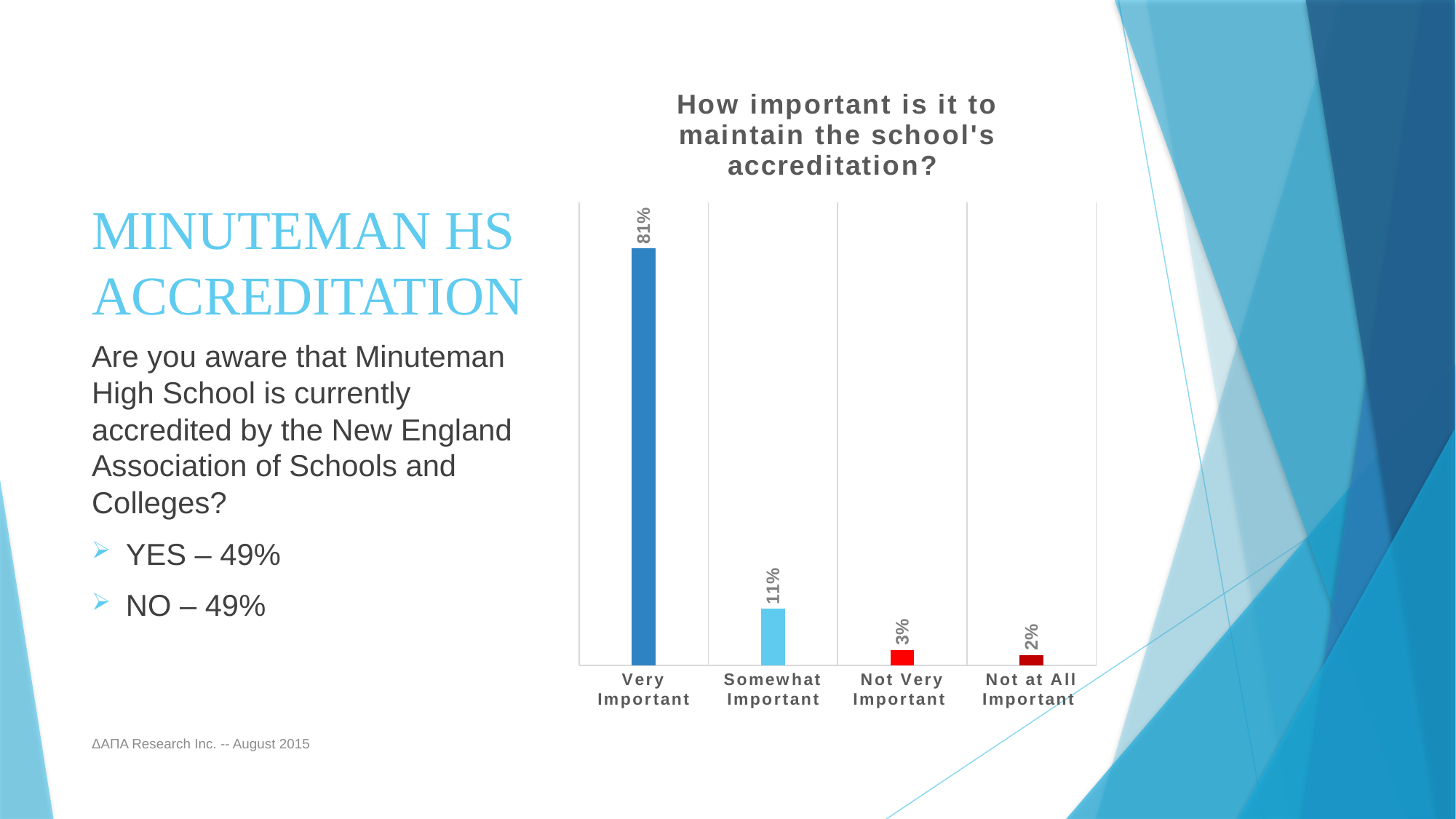
What is the value for Not Very Important? 3% Which category has the lowest value? Not at All Important Which category has the highest value? Very Important What is the difference between the Very Important and Somewhat Important values? 70% Which is larger, the value for Somewhat Important or the value for Not Very Important? Somewhat Important What is the title of the chart? How important is it to maintain the school's accreditation? What is the difference between the Not Very Important and Not at All Important values? 1% What is the value for Somewhat Important? 11% What is the value for Not at All Important? 2% What kind of chart is shown on the slide? Bar chart How many categories are shown in the chart? 4 What percentage of respondents said maintaining the school's accreditation is Very Important? 81%